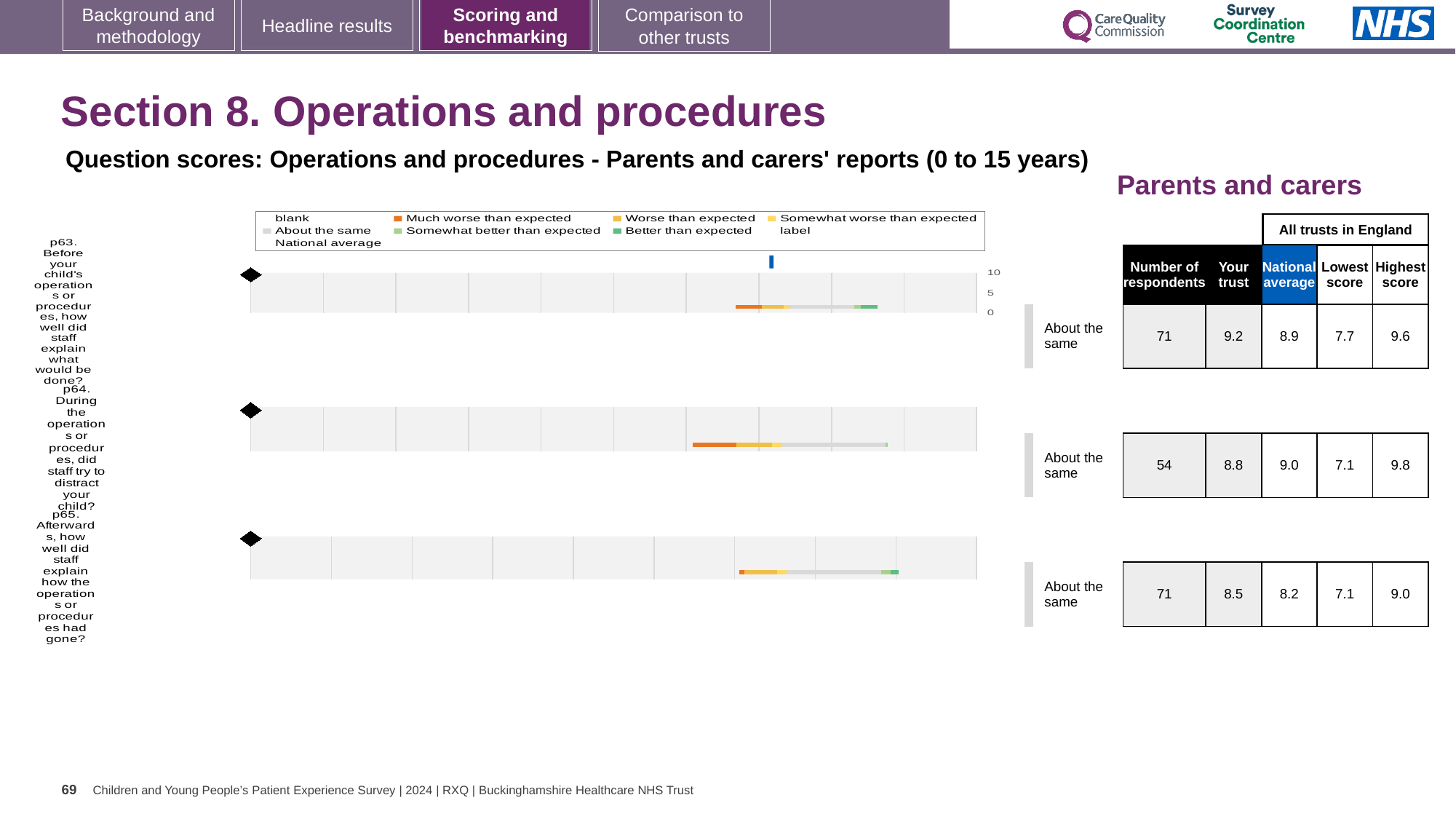
What is the national average score for p64 (During the operations or procedures, did staff try to distract your child?)? 9.0 How many respondents answered p64? 54 For p64, which is larger: the 'Your trust' score or the national average? National average How many questions (p63, p64, p65) are plotted as separate chart rows on the slide? 3 What colour does the legend use for 'Much worse than expected'? Orange What is the 'Your trust' score for p63 (Before your child's operations or procedures, how well did staff explain what would be done?)? 9.2 Which question has the highest 'Your trust' score? p63 For p63, how much higher is the 'Your trust' score than the national average? 0.3 What benchmark category is shown for p65 (Afterwards, how well did staff explain how the operations or procedures had gone?)? About the same Which question has the lowest 'Your trust' score? p65 What kind of chart is used to show the question scores for p63, p64 and p65? bar chart What is the highest score among all trusts in England for p64? 9.8